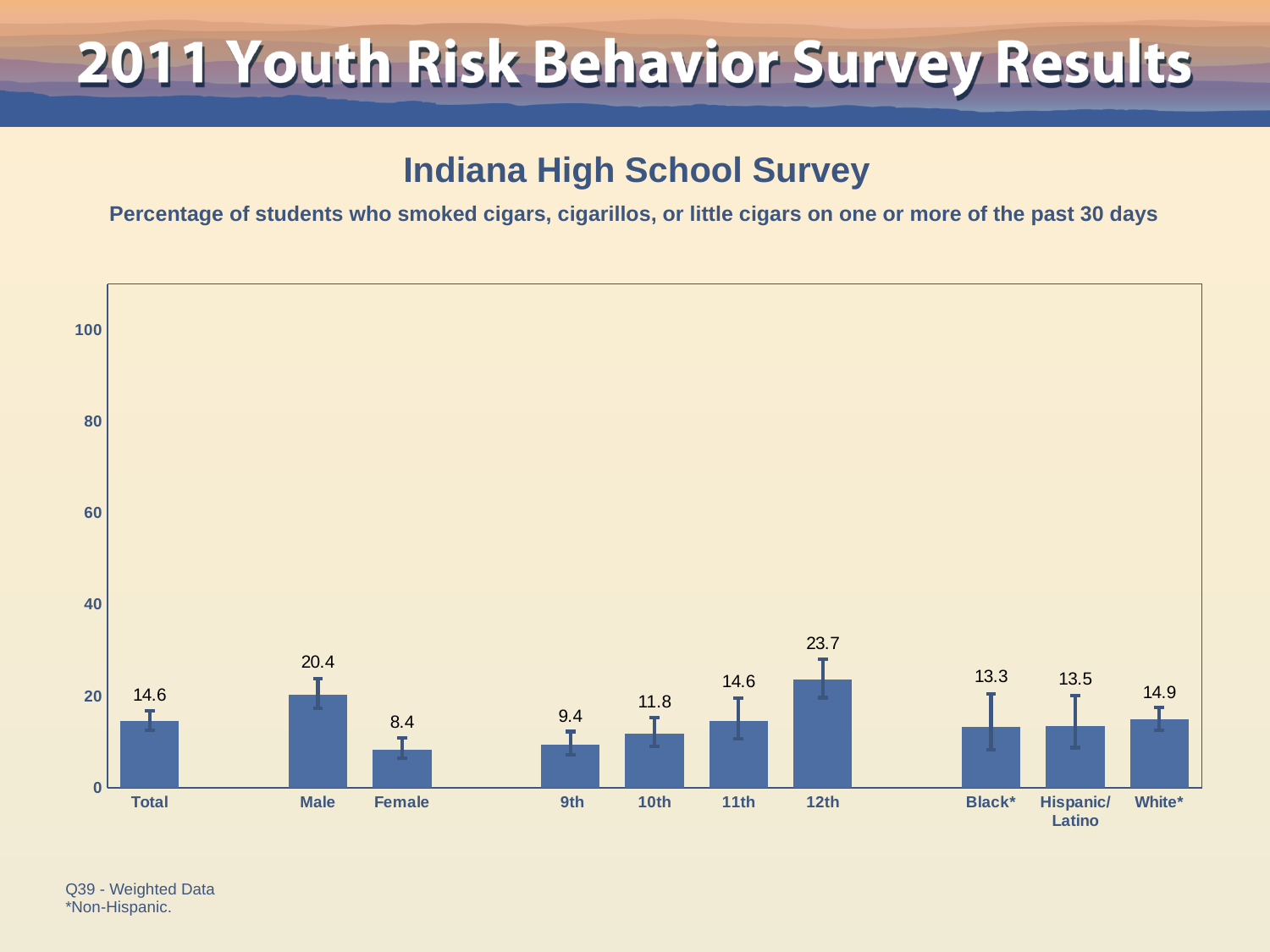
Is the value for 12th greater or less than 20? greater Do the values rise or fall from 9th to 12th grade? rise What is the value for Male? 20.4 What kind of chart is this? bar chart Which category has the lowest value? Female What is the difference between the Male and Female values? 12.0 Which is larger, the value for 9th or the value for 10th? 10th What is the difference between the White* and Black* values? 1.6 What is the value for Hispanic/Latino? 13.5 Which category has the highest value? 12th What is the value for 12th grade? 23.7 How many categories are shown on the x axis? 10